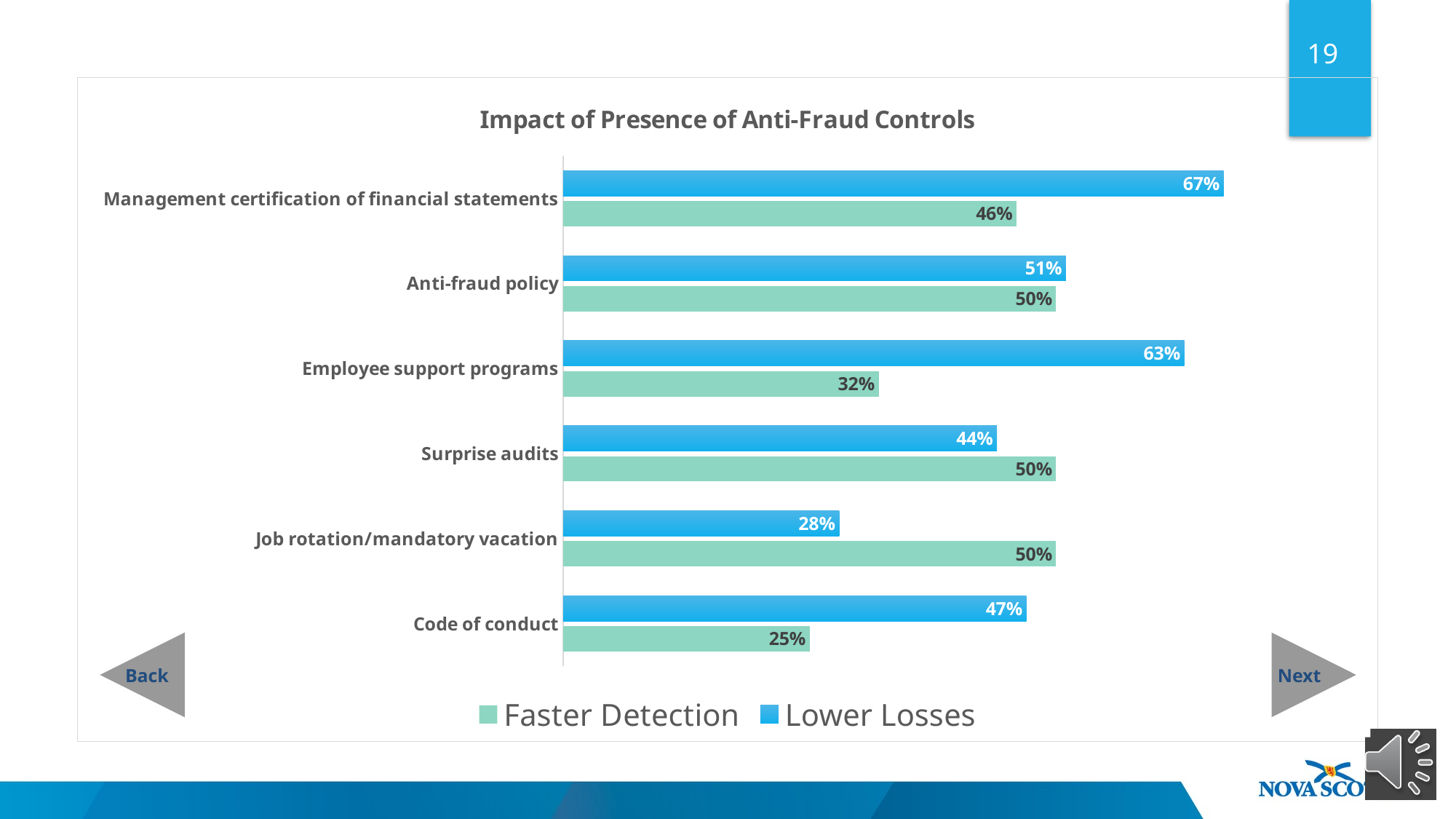
How many categories are shown on the chart? 6 What is the Lower Losses value for Management certification of financial statements? 67% What is the Faster Detection value for Employee support programs? 32% What is the difference between the Lower Losses and Faster Detection values for Employee support programs? 31% Which category has the highest Lower Losses value? Management certification of financial statements What is the title of the chart? Impact of Presence of Anti-Fraud Controls What kind of chart is shown on the slide? Bar chart How many series does the legend list? 2 What is the Faster Detection value for Code of conduct? 25% Which category has the lowest Lower Losses value? Job rotation/mandatory vacation For Surprise audits, which is larger: Faster Detection or Lower Losses? Faster Detection Which category has the lowest Faster Detection value? Code of conduct